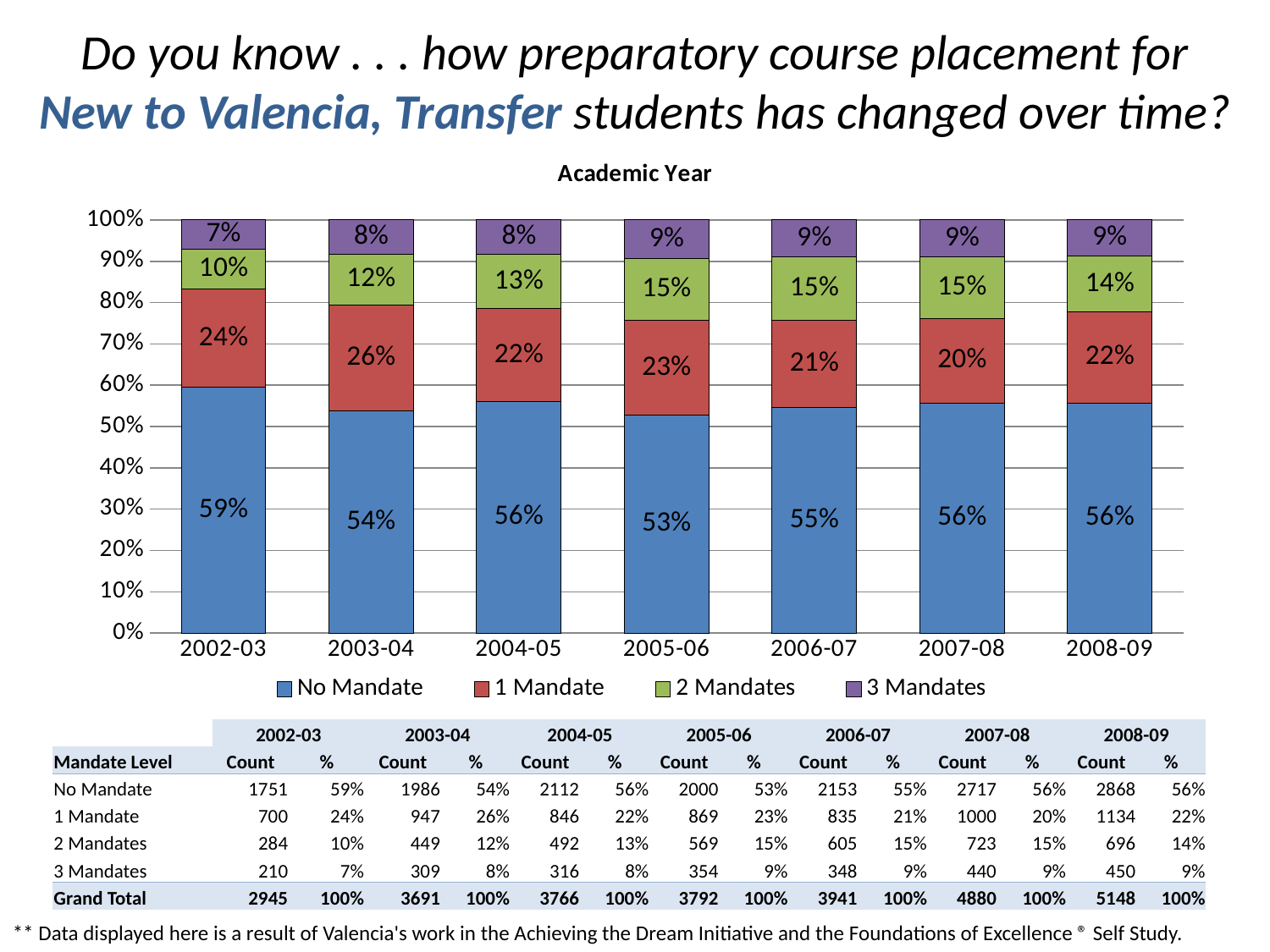
What kind of chart is shown? Stacked bar chart What is the 3 Mandates share for 2008-09? 9% How many academic years are shown on the x axis? 7 Does the 3 Mandates share rise or fall from 2002-03 to 2008-09? Rise What is the difference between the 1 Mandate share in 2003-04 and in 2007-08? 6% What is the No Mandate share for 2002-03? 59% Which is larger, the 2 Mandates share in 2002-03 or in 2004-05? 2004-05 What is the 2 Mandates share for 2005-06? 15% What is the 1 Mandate share for 2003-04? 26% In which academic year is the No Mandate share lowest? 2005-06 How many series does the legend list? 4 In which academic year is the No Mandate share highest? 2002-03